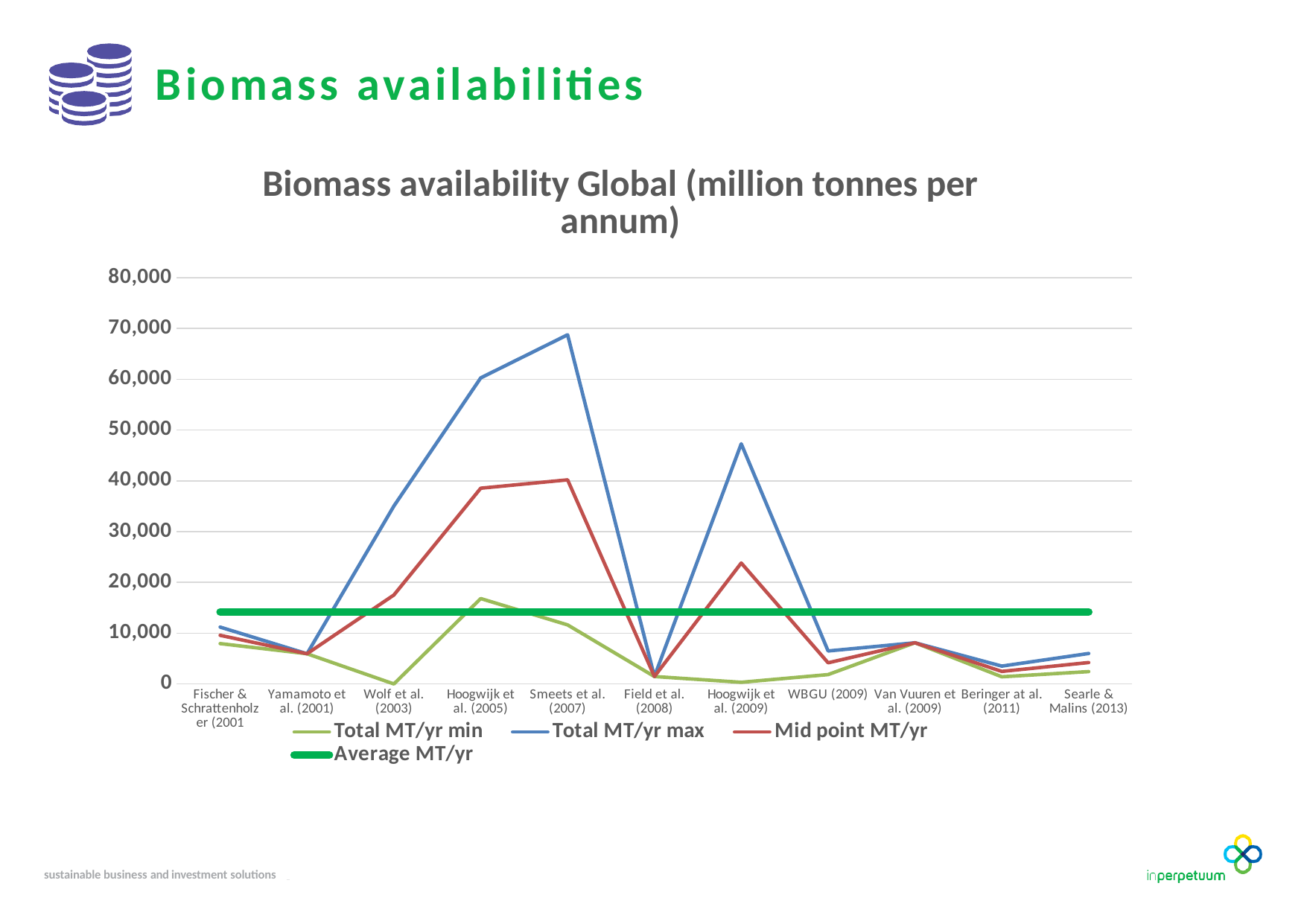
For which study is the Total MT/yr min value highest? Hoogwijk et al. (2005) For which study is the Mid point MT/yr value highest? Smeets et al. (2007) Is the Total MT/yr max value for Hoogwijk et al. (2009) greater or less than 50,000? less How many studies (categories) are plotted along the x axis? 11 How many series does the legend list? 4 Is the Mid point MT/yr value for Hoogwijk et al. (2005) greater or less than 30,000? greater What is the title of the chart? Biomass availability Global (million tonnes per annum) Is the Total MT/yr max value for Smeets et al. (2007) greater or less than 60,000? greater For which study is the Total MT/yr max value highest? Smeets et al. (2007) What kind of chart is shown on the slide? Line chart Which has the larger Total MT/yr max value, Hoogwijk et al. (2005) or Hoogwijk et al. (2009)? Hoogwijk et al. (2005) Which series is drawn as the thick green horizontal line? Average MT/yr